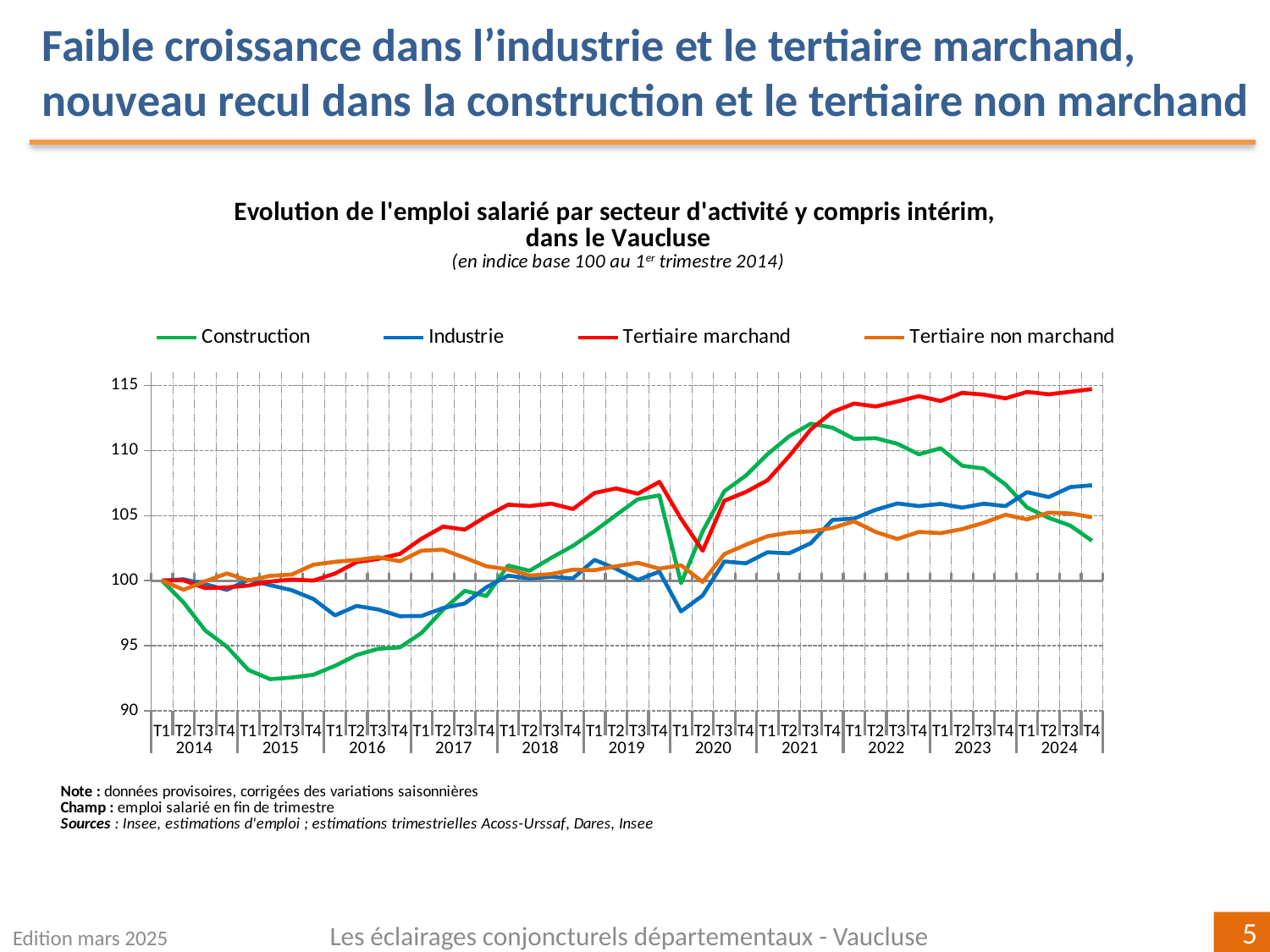
Which series has the lowest value at T4 2024? Construction Is the value for Construction at T2 2015 greater or less than 95? less Which series reaches the lowest point anywhere on the chart? Construction Does the Construction series rise or fall between T1 2014 and T2 2015? fall Is the value for Tertiaire marchand at T4 2024 greater or less than 110? greater How many years are labelled along the x axis? 11 What kind of chart is shown on the slide? Line chart Is the value for Industrie at T1 2020 greater or less than 100? less Which series is plotted in green? Construction How many series does the legend list? 4 Which series has the highest value at T4 2024? Tertiaire marchand What is the base value of the index, as stated in the chart subtitle? 100 au 1er trimestre 2014